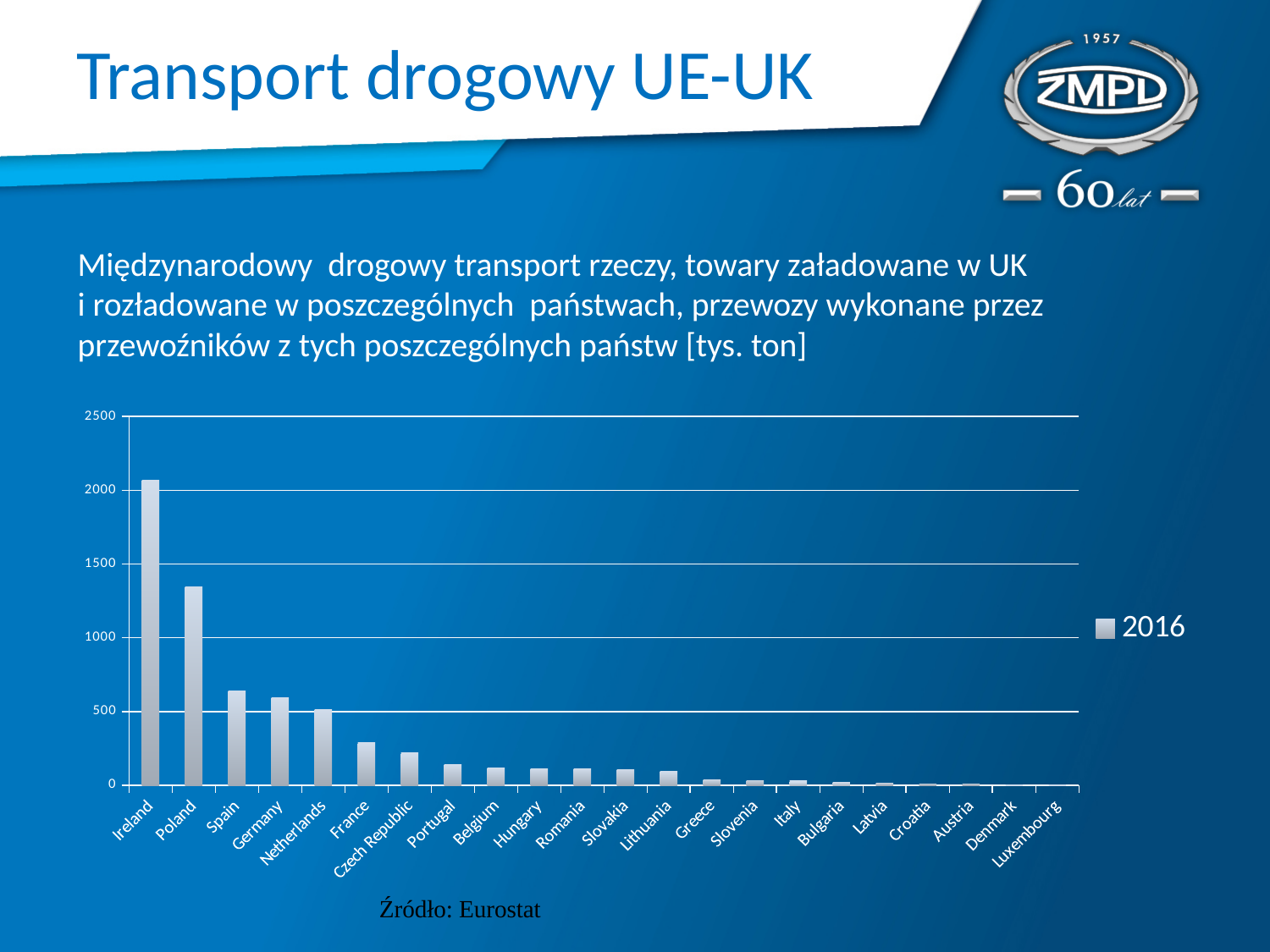
Is the value for Ireland greater or less than 2000? greater Which has a larger value, Poland or Spain? Poland Is the value for Poland greater or less than 1000? greater Is the value for Poland greater or less than 1500? less How many countries are shown on the x axis of the chart? 22 How many series does the chart legend list? 1 Which country has the highest value in the chart? Ireland Do the values rise or fall moving from left to right along the x axis? fall Which has a larger value, France or Germany? Germany Which year is named in the chart legend? 2016 What kind of chart is shown on the slide? bar chart